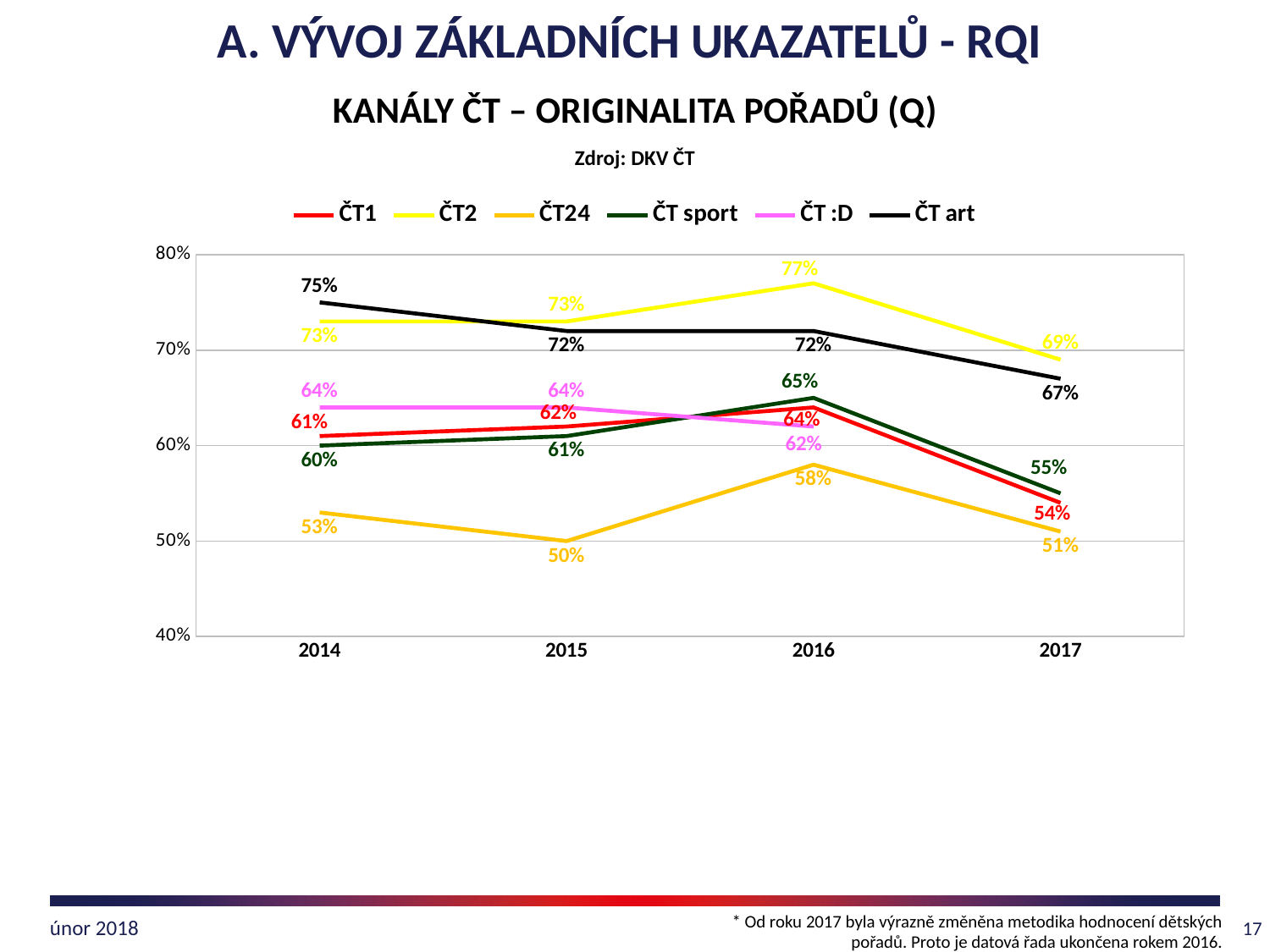
What is the value for ČT art in 2014? 75% What is the value for ČT2 in 2016? 77% How many series does the legend list? 6 Which channel has the highest value in 2016? ČT2 Does the value for ČT art rise or fall from 2014 to 2017? fall Which is larger in 2015, the value for ČT1 or the value for ČT24? ČT1 What is the difference between ČT art and ČT1 in 2017? 13% What is the value for ČT24 in 2015? 50% How many years are shown on the x axis? 4 Which channel has the lowest value in 2014? ČT24 What kind of chart is shown on the slide? line chart What is the value for ČT sport in 2017? 55%